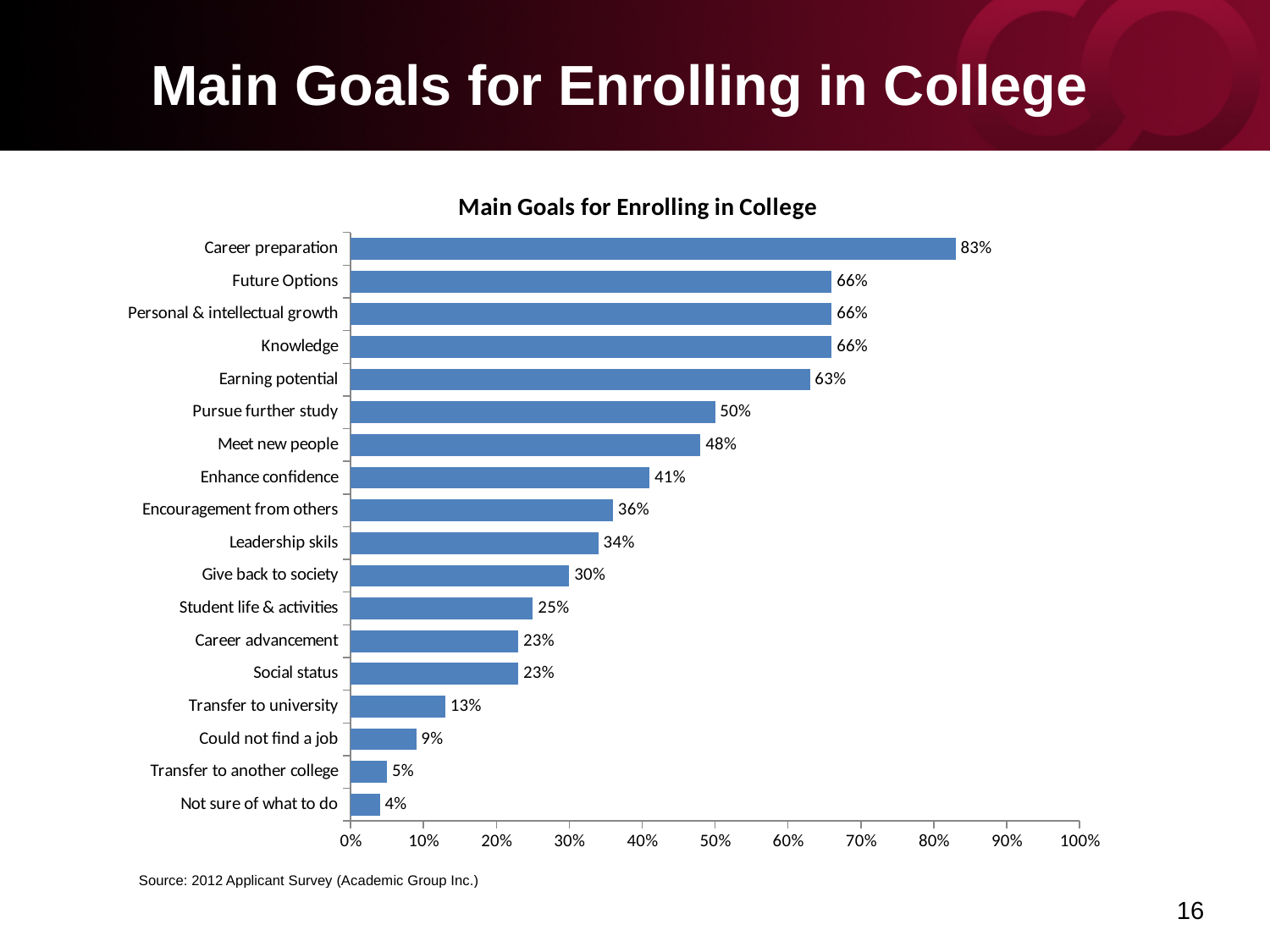
Which category has the highest value? Career preparation What is the title of the chart? Main Goals for Enrolling in College What is the value for Transfer to university? 13% Which is larger, Enhance confidence or Leadership skils? Enhance confidence What is the difference between Pursue further study and Give back to society? 20% What is the value for Career preparation? 83% What is the value for Meet new people? 48% How many categories are shown in the chart? 18 Which category has the lowest value? Not sure of what to do What is the difference between Career preparation and Earning potential? 20% What kind of chart is this? bar chart Is the value for Encouragement from others greater or less than 40%? less